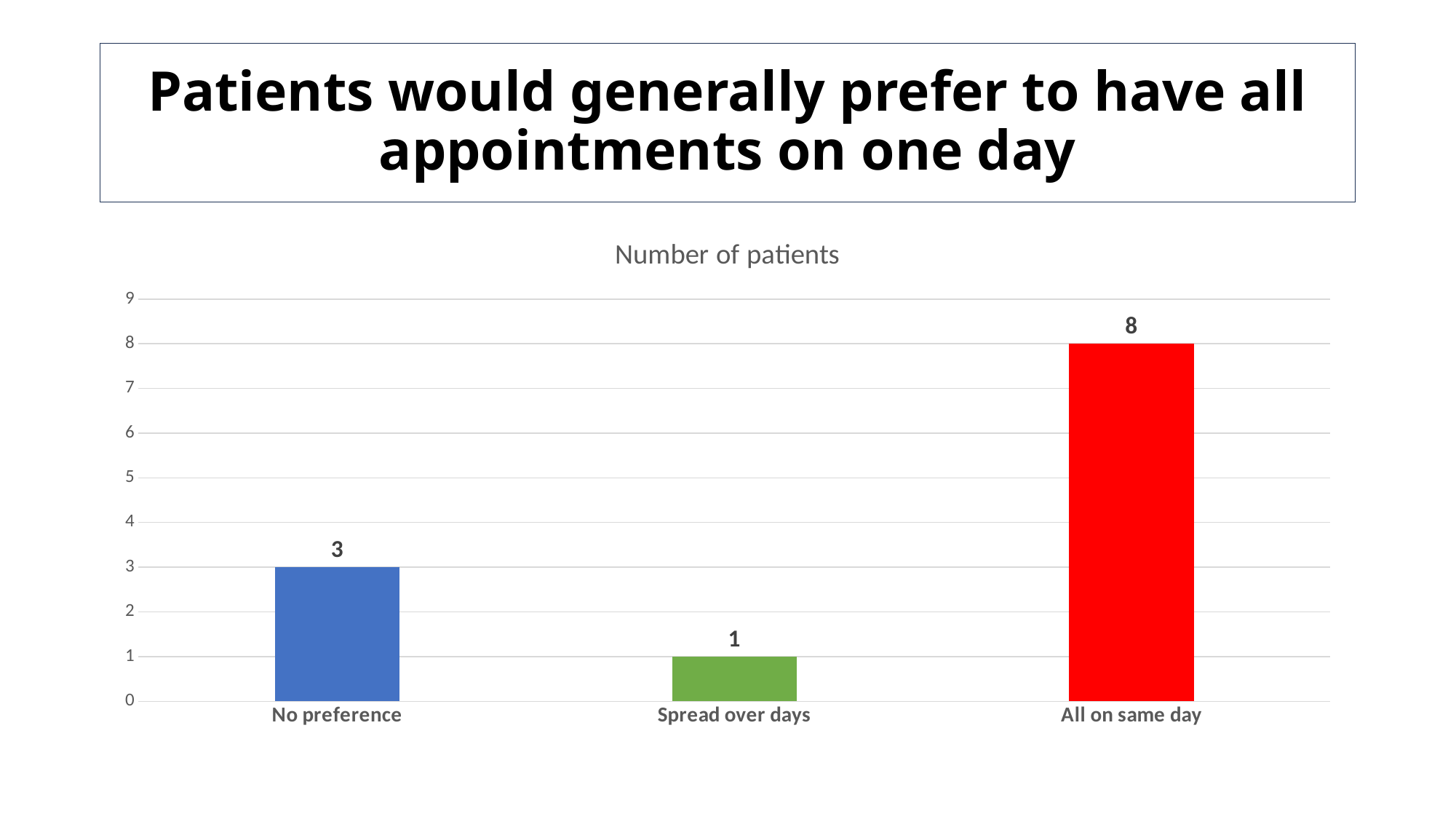
Which has more patients, 'No preference' or 'Spread over days'? No preference What is the title of the chart? Number of patients What is the difference in number of patients between 'No preference' and 'Spread over days'? 2 What is the number of patients for 'All on same day'? 8 What kind of chart is shown on the slide? Bar chart What is the number of patients for 'Spread over days'? 1 What is the difference in number of patients between 'All on same day' and 'No preference'? 5 How many categories are shown on the chart? 3 What is the number of patients for 'No preference'? 3 Which category has the highest number of patients? All on same day Which category has the lowest number of patients? Spread over days Is the value for 'All on same day' greater or less than 5? greater